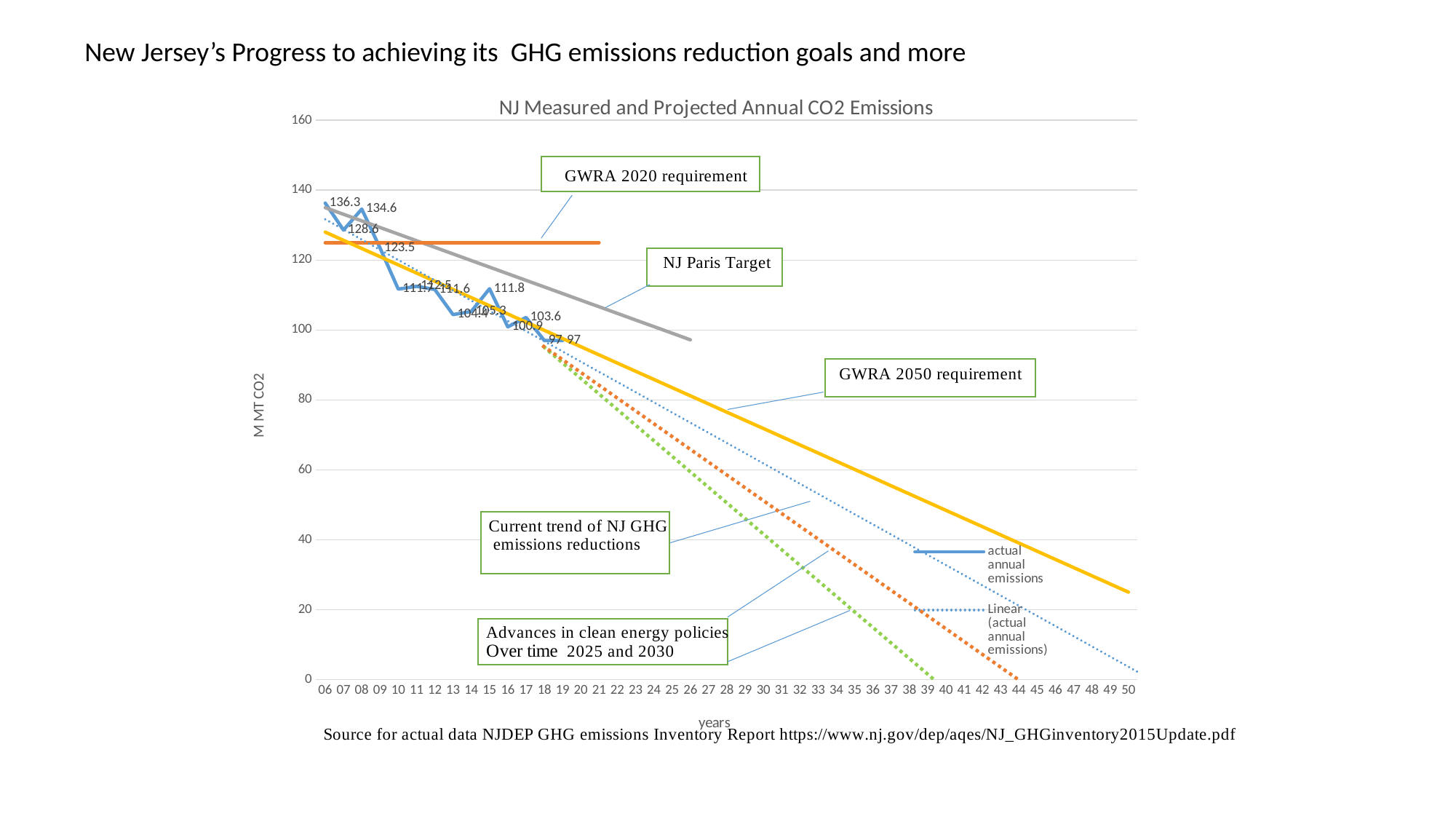
Is the GWRA 2050 requirement line at year 50 greater or less than 40? less How many series does the legend list? 2 What is the title of the chart? NJ Measured and Projected Annual CO2 Emissions What kind of chart is shown on the slide? line chart What is the actual annual emissions value for year 08? 134.6 What is the label on the vertical axis? M MT CO2 What is the actual annual emissions value for year 06? 136.3 In which year is the actual annual emissions value highest? 06 Which year has the larger actual annual emissions value, 09 or 15? 09 What is the actual annual emissions value for year 17? 103.6 What is the difference between the actual annual emissions values for years 06 and 08? 1.7 What is the actual annual emissions value for year 15? 111.8